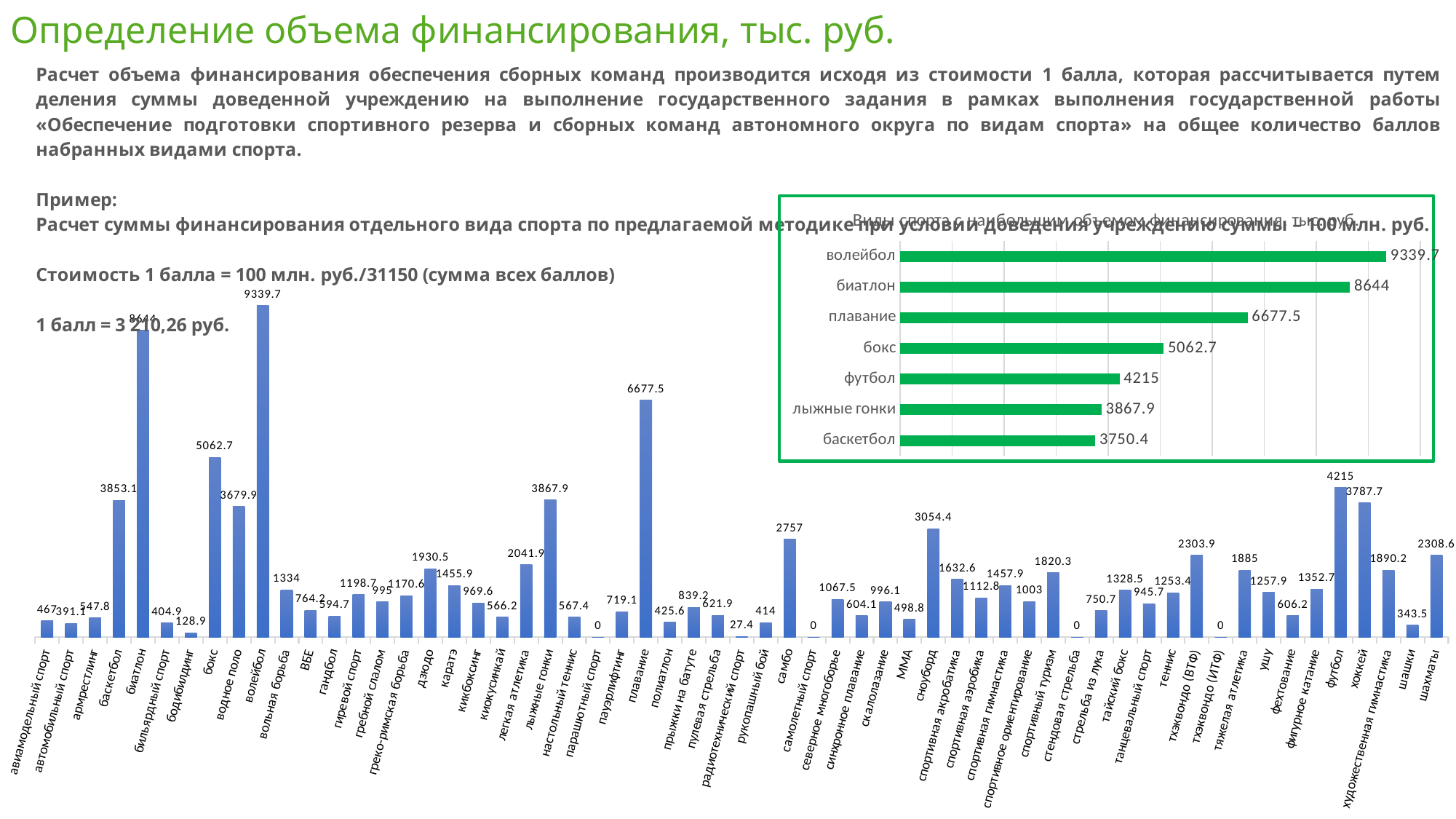
In the large blue bar chart, what is the difference between the values for плавание and бокс? 1614.8 In the green horizontal bar chart in the top right, which sport has the lowest value? баскетбол In the large blue bar chart, which is larger, the value for дзюдо or the value for каратэ? дзюдо In the large blue bar chart, which sport has the highest value? волейбол In the green horizontal bar chart in the top right, what is the difference between the values for волейбол and биатлон? 695.7 In the green horizontal bar chart in the top right, what is the value for бокс? 5062.7 What colour are the bars in the horizontal bar chart in the top right? green What kind of chart is the large blue chart at the bottom of the slide? bar chart In the green horizontal bar chart in the top right, which sport has the highest value? волейбол In the large blue bar chart, what is the value for шахматы? 2308.6 In the large blue bar chart, what is the value for самбо? 2757 How many sports are shown in the green horizontal bar chart in the top right? 7